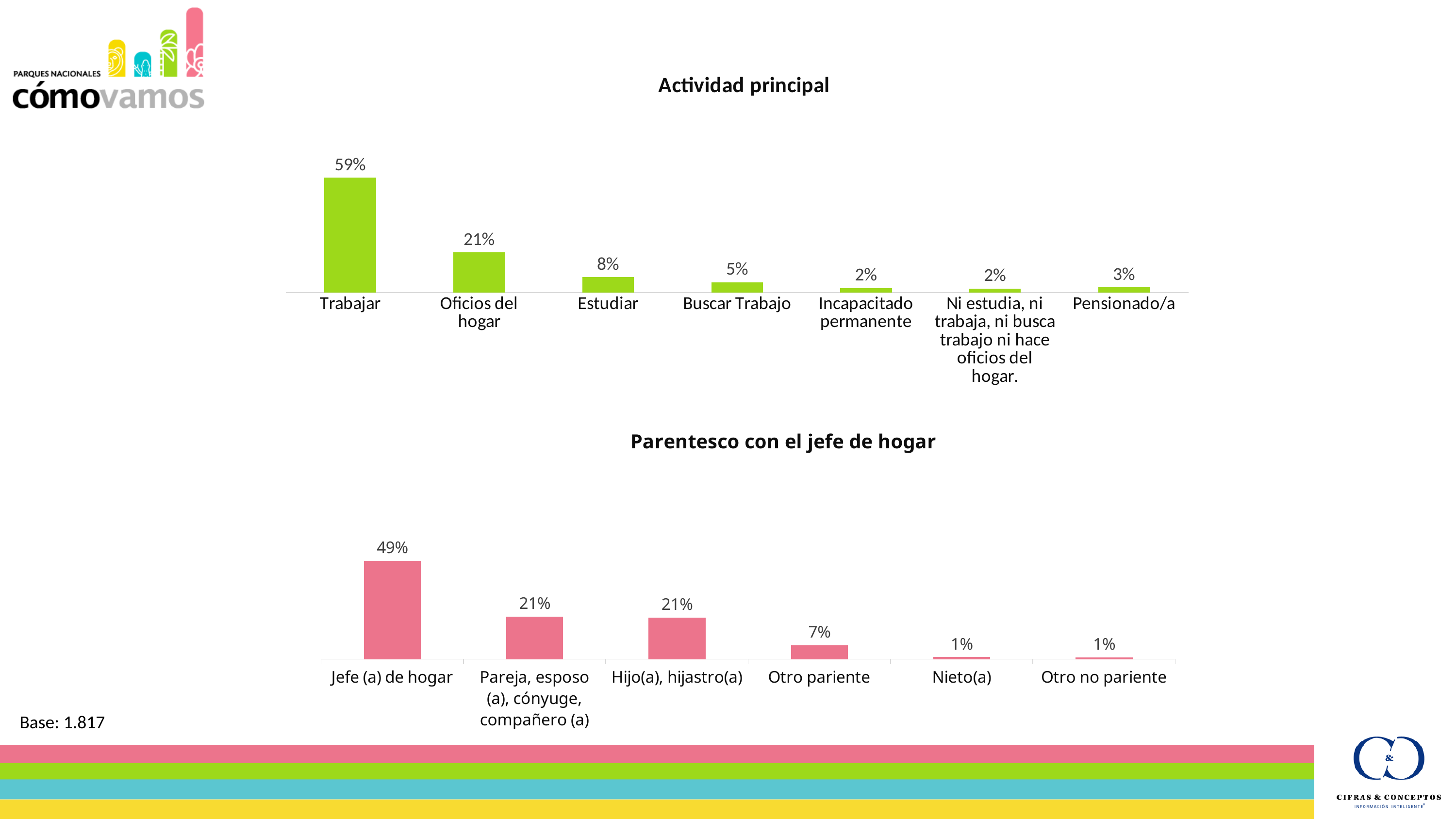
In the 'Actividad principal' chart, what is the difference between Trabajar and Oficios del hogar? 38% In the 'Parentesco con el jefe de hogar' chart, what is the value for Otro pariente? 7% In the 'Parentesco con el jefe de hogar' chart, which category has the highest value? Jefe (a) de hogar In the 'Parentesco con el jefe de hogar' chart, what is the difference between Jefe (a) de hogar and Hijo(a), hijastro(a)? 28% In the 'Actividad principal' chart, what is the value for Trabajar? 59% In the 'Parentesco con el jefe de hogar' chart, how many categories are shown? 6 In the 'Parentesco con el jefe de hogar' chart, what is the value for Jefe (a) de hogar? 49% In the 'Actividad principal' chart, what is the value for Estudiar? 8% In the 'Actividad principal' chart, which category has the highest value? Trabajar What type of chart is the 'Parentesco con el jefe de hogar' chart? Bar chart In the 'Actividad principal' chart, which is larger: Buscar Trabajo or Pensionado/a? Buscar Trabajo In the 'Actividad principal' chart, how many categories are shown? 7